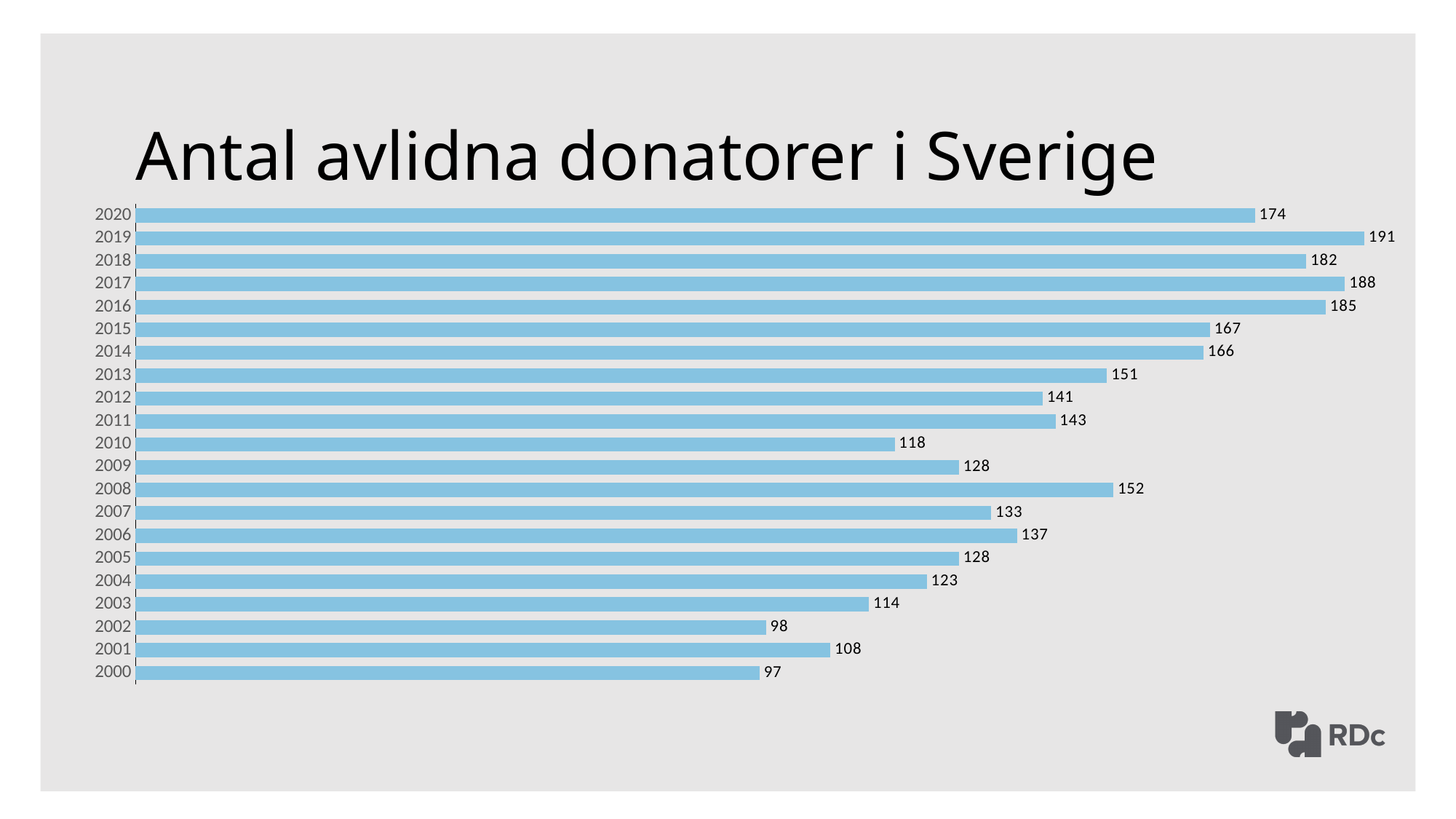
What is the value for 2020? 174 Which year has the highest value? 2019 Which is larger, the value for 2002 or the value for 2001? 2001 How many years are shown in the chart? 21 What is the title of the chart? Antal avlidna donatorer i Sverige What is the difference between the values for 2008 and 2007? 19 What kind of chart is shown on the slide? Bar chart What is the difference between the values for 2019 and 2020? 17 Which is larger, the value for 2012 or the value for 2011? 2011 Which year has the lowest value? 2000 What is the value for 2000? 97 What is the value for 2010? 118